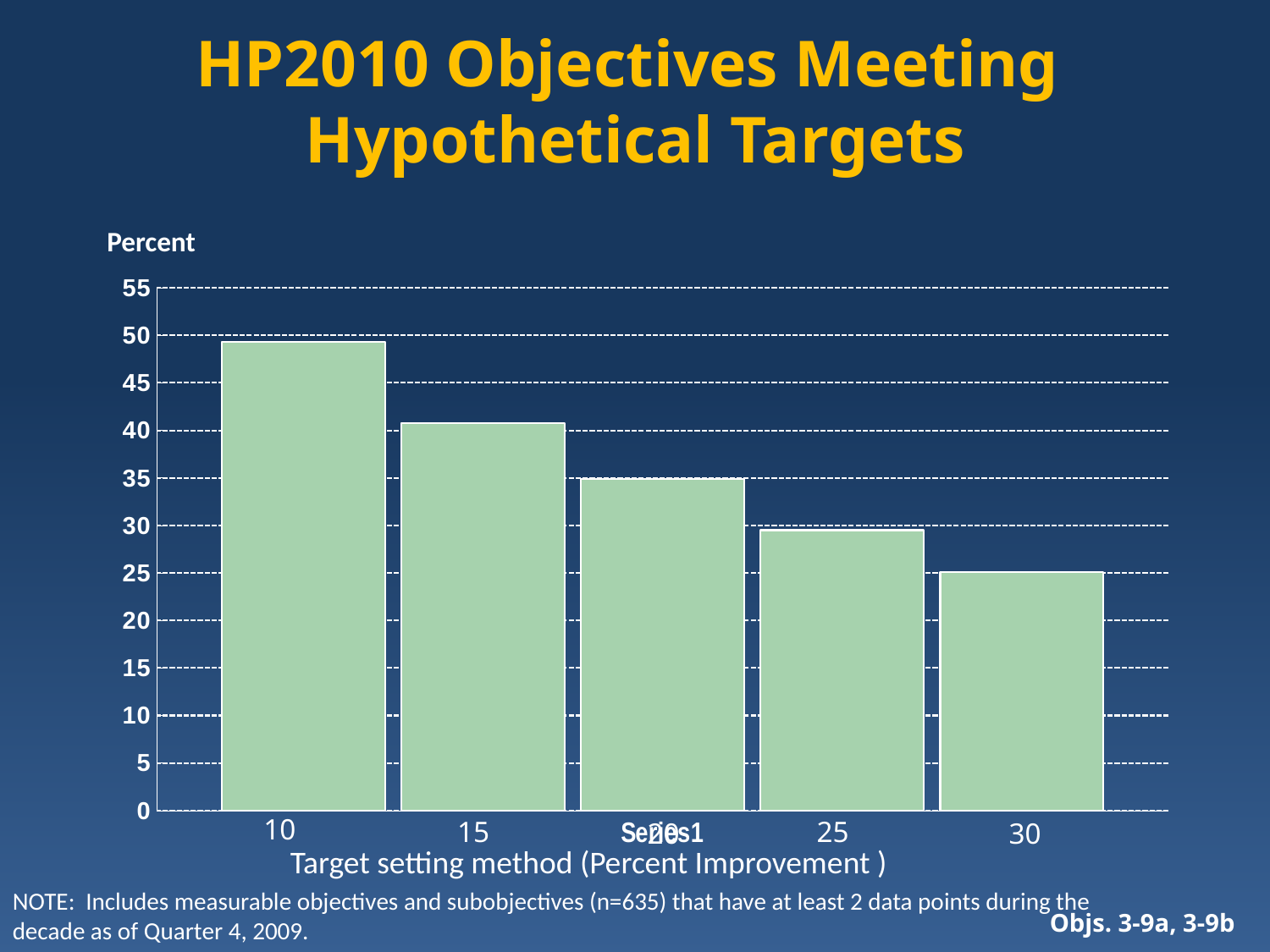
What is the label on the x axis of the chart? Target setting method (Percent Improvement ) How many bars (target setting methods) are plotted in the chart? 5 What kind of chart is shown on the slide? bar chart Is the value for the 10 percent improvement method greater or less than 45? greater Is the value for the 30 percent improvement method greater or less than 30? less Is the value for the 25 percent improvement method greater or less than 25? greater Do the values rise or fall as the target setting method increases from 10 to 30 along the x axis? fall Which target setting method has the highest percent of objectives meeting the hypothetical target? 10 Which target setting method has the lowest percent of objectives meeting the hypothetical target? 30 Which has a larger value, the 15 percent improvement method or the 25 percent improvement method? 15